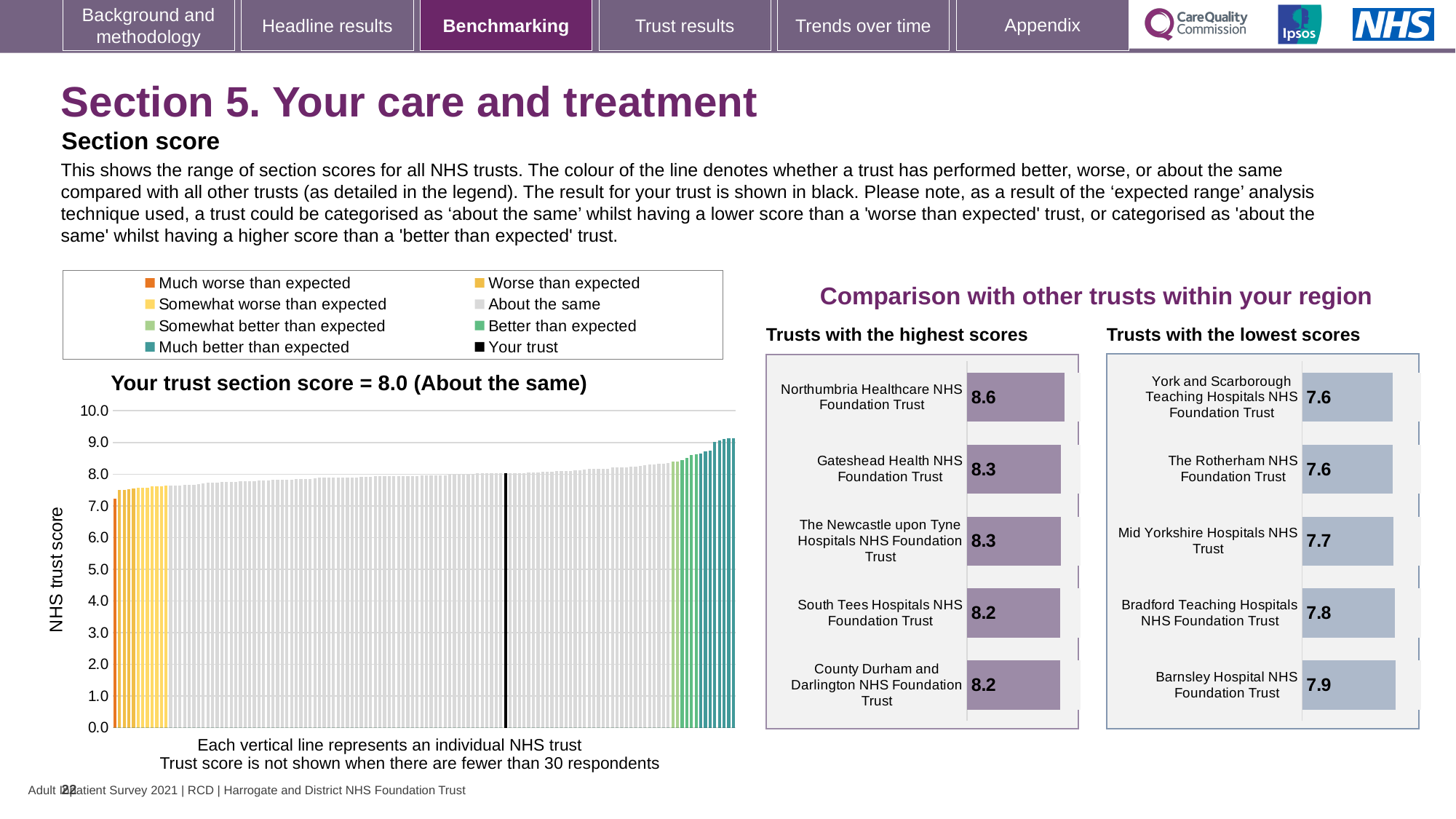
On the 'Trusts with the highest scores' chart, what is the score for Northumbria Healthcare NHS Foundation Trust? 8.6 On the 'Trusts with the highest scores' chart, which trust has the highest score? Northumbria Healthcare NHS Foundation Trust On the 'Trusts with the lowest scores' chart, what is the score for Mid Yorkshire Hospitals NHS Trust? 7.7 On the 'Your trust section score' chart, what is the label of the vertical axis? NHS trust score On the 'Your trust section score' chart, do the trust scores rise or fall from left to right along the x axis? rise On the 'Trusts with the lowest scores' chart, which has the larger score, Bradford Teaching Hospitals NHS Foundation Trust or Mid Yorkshire Hospitals NHS Trust? Bradford Teaching Hospitals NHS Foundation Trust On the 'Trusts with the lowest scores' chart, which trust has the highest score? Barnsley Hospital NHS Foundation Trust On the 'Trusts with the highest scores' chart, what is the difference between the scores of Northumbria Healthcare NHS Foundation Trust and South Tees Hospitals NHS Foundation Trust? 0.4 On the 'Trusts with the highest scores' chart, how many trusts are shown? 5 On the 'Your trust section score' chart, what kind of chart is shown? bar chart On the 'Your trust section score' chart, how many entries does the legend list? 8 On the 'Your trust section score' chart, what is the section score for your trust? 8.0